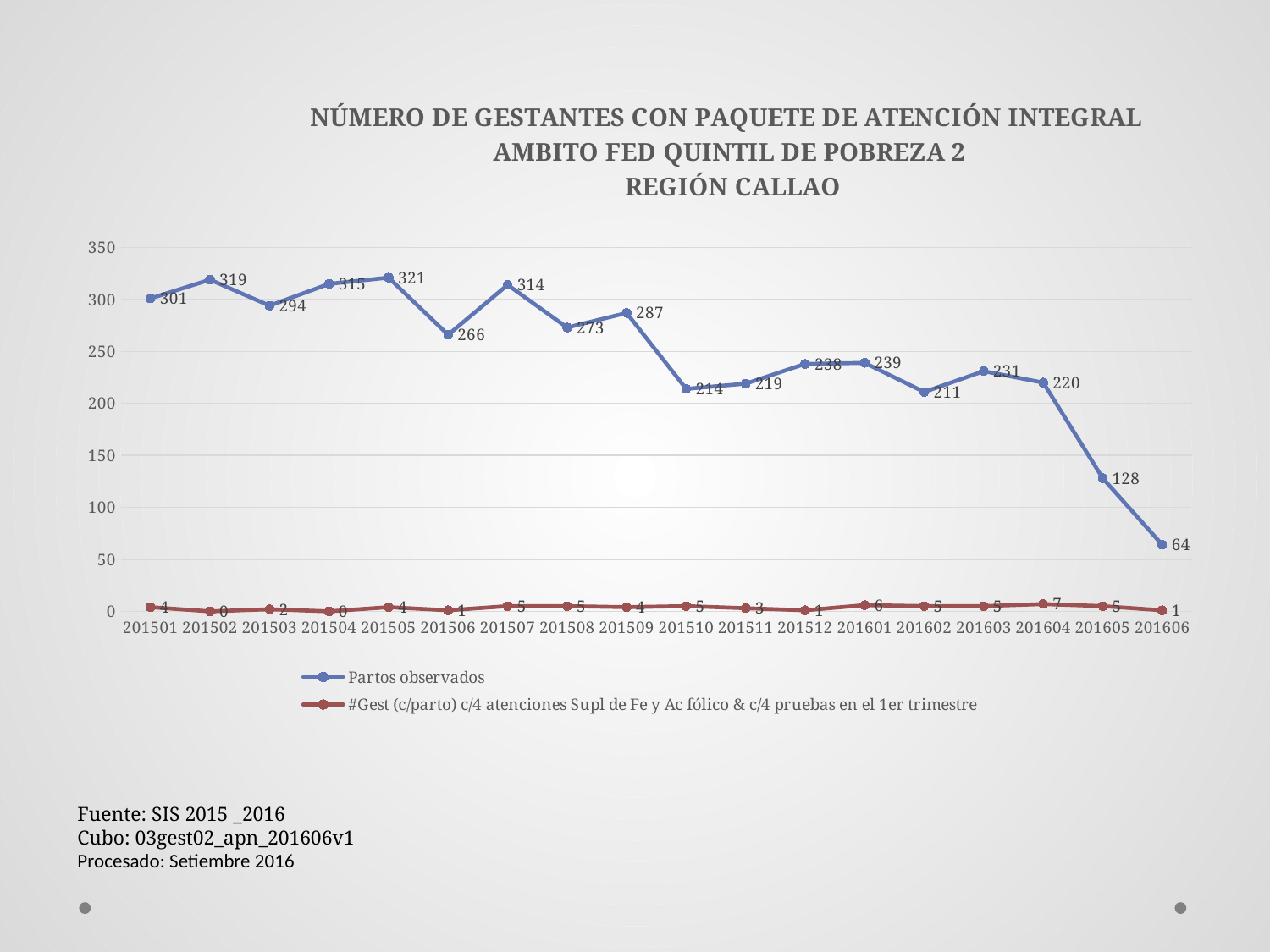
In which period is Partos observados highest? 201505 In which period does the #Gest (c/parto) series reach its highest value? 201604 What is the value of Partos observados for 201505? 321 How many series does the legend list? 2 In which period is Partos observados lowest? 201606 What is the value of the #Gest (c/parto) series for 201604? 7 What is the difference between Partos observados in 201502 and 201501? 18 What is the difference between Partos observados in 201604 and 201605? 92 Which period has a larger value of Partos observados, 201507 or 201509? 201507 What kind of chart is shown on the slide? Line chart What is the value of Partos observados for 201606? 64 How many periods are plotted on the x axis? 18